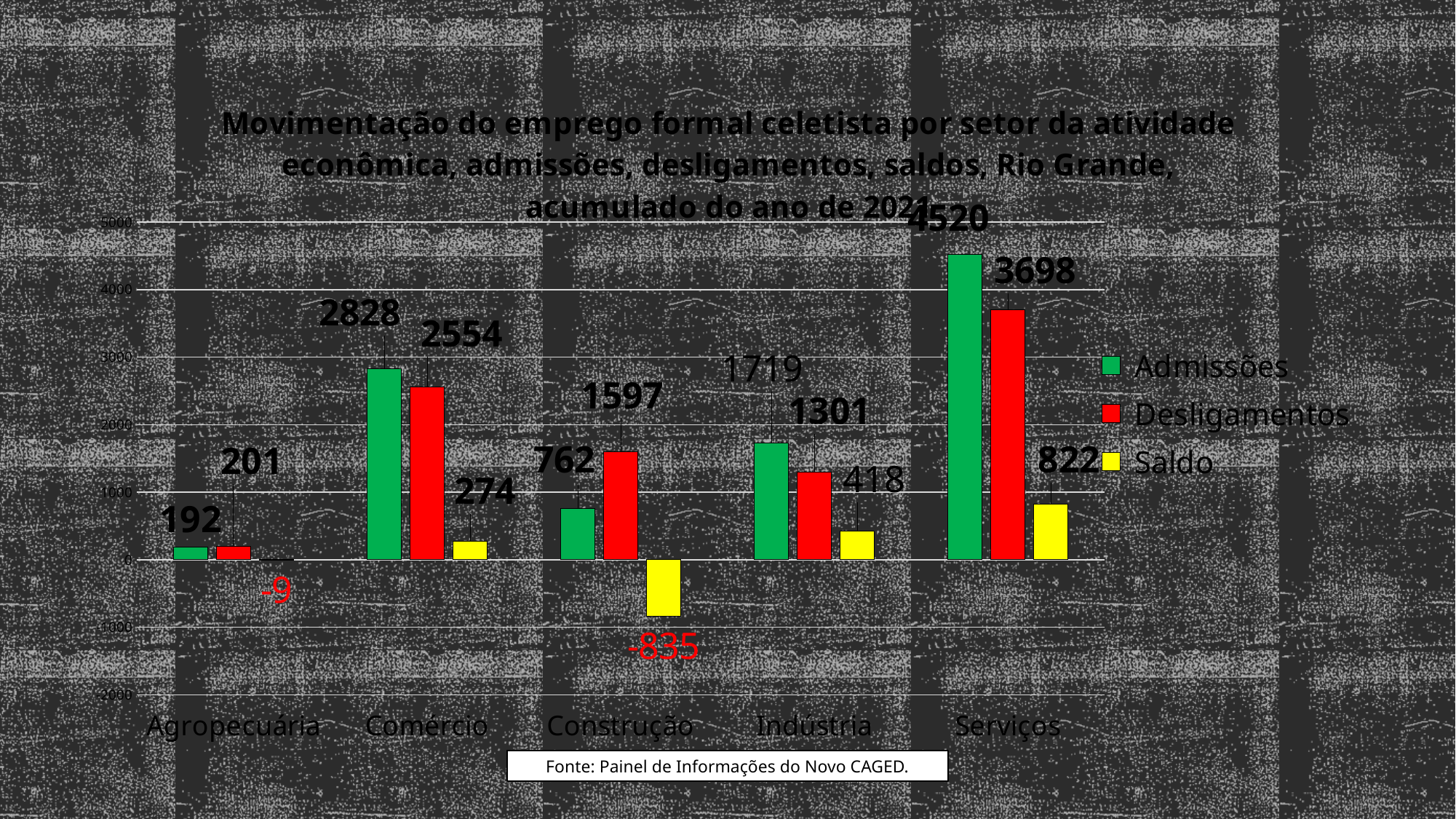
What is the Saldo value for Construção? -835 Which sector has the highest Admissões value? Serviços What is the Saldo value for Agropecuária? -9 What is the value of Desligamentos for Comércio? 2554 Which colour represents the Saldo series? Yellow What is the difference between Admissões and Desligamentos for Indústria? 418 Which is larger for Construção, Admissões or Desligamentos? Desligamentos Which sector has the lowest Saldo value? Construção What kind of chart is shown on the slide? Bar chart How many sectors are shown on the x axis? 5 How many series does the legend list? 3 What is the value of Admissões for Serviços? 4520